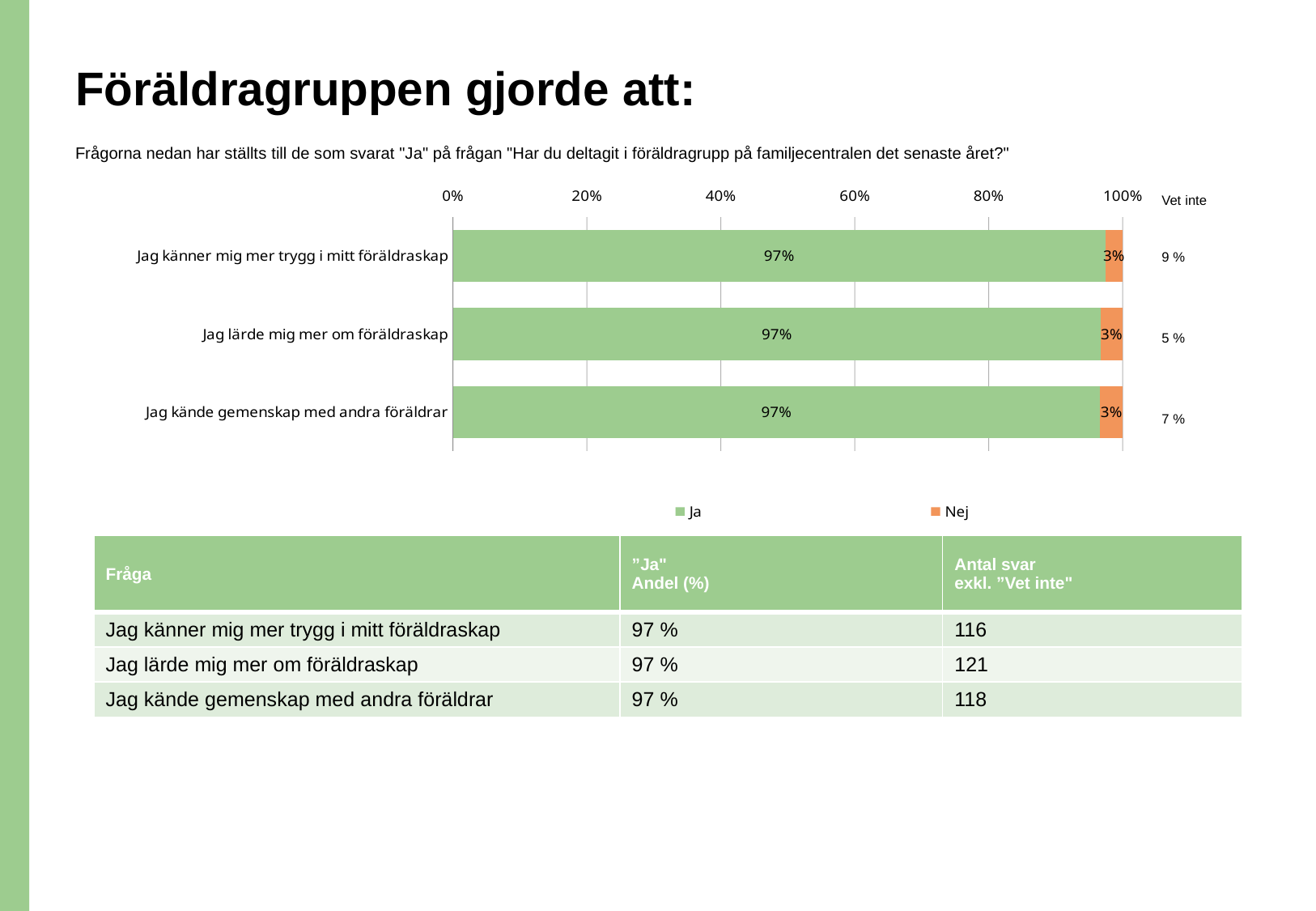
What is the "Vet inte" share shown next to "Jag kände gemenskap med andra föräldrar"? 7 % What is the difference between the "Ja" and "Nej" shares for "Jag kände gemenskap med andra föräldrar"? 94% What percentage answered "Nej" to "Jag lärde mig mer om föräldraskap"? 3% What kind of chart is shown on the slide? Stacked bar chart What percentage answered "Ja" to "Jag känner mig mer trygg i mitt föräldraskap"? 97% What is the "Vet inte" share shown next to "Jag känner mig mer trygg i mitt föräldraskap"? 9 % How many categories (statements) are plotted in the chart? 3 What is the total of the "Ja" and "Nej" segments for "Jag lärde mig mer om föräldraskap"? 100% Which series is shown in orange in the chart? Nej What percentage answered "Ja" to "Jag kände gemenskap med andra föräldrar"? 97% What is the "Vet inte" share shown next to "Jag lärde mig mer om föräldraskap"? 5 % How many series does the chart legend list? 2